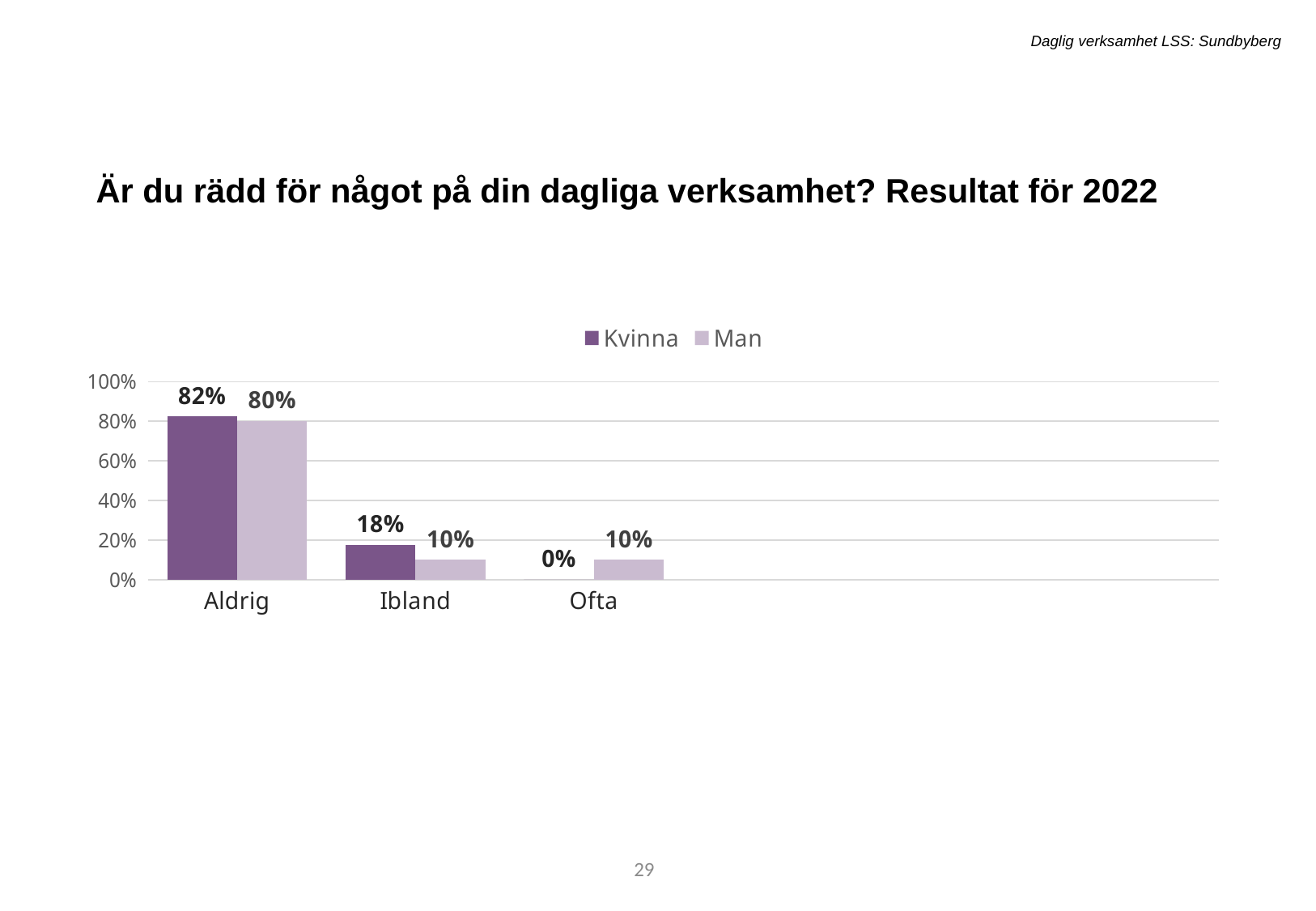
What are the two series named in the legend? Kvinna and Man What is the difference between the Kvinna and Man values in the Ibland category? 8% In the Ofta category, which series has the larger value, Kvinna or Man? Man How many categories are shown on the x axis? 3 What is the value for Man in the Aldrig category? 80% What is the value for Kvinna in the Aldrig category? 82% Which category has the lowest value for the Kvinna series? Ofta What is the value for Man in the Ibland category? 10% What kind of chart is shown on the slide? Bar chart What is the value for Kvinna in the Ofta category? 0% How many series does the legend list? 2 Which category has the highest value for the Man series? Aldrig